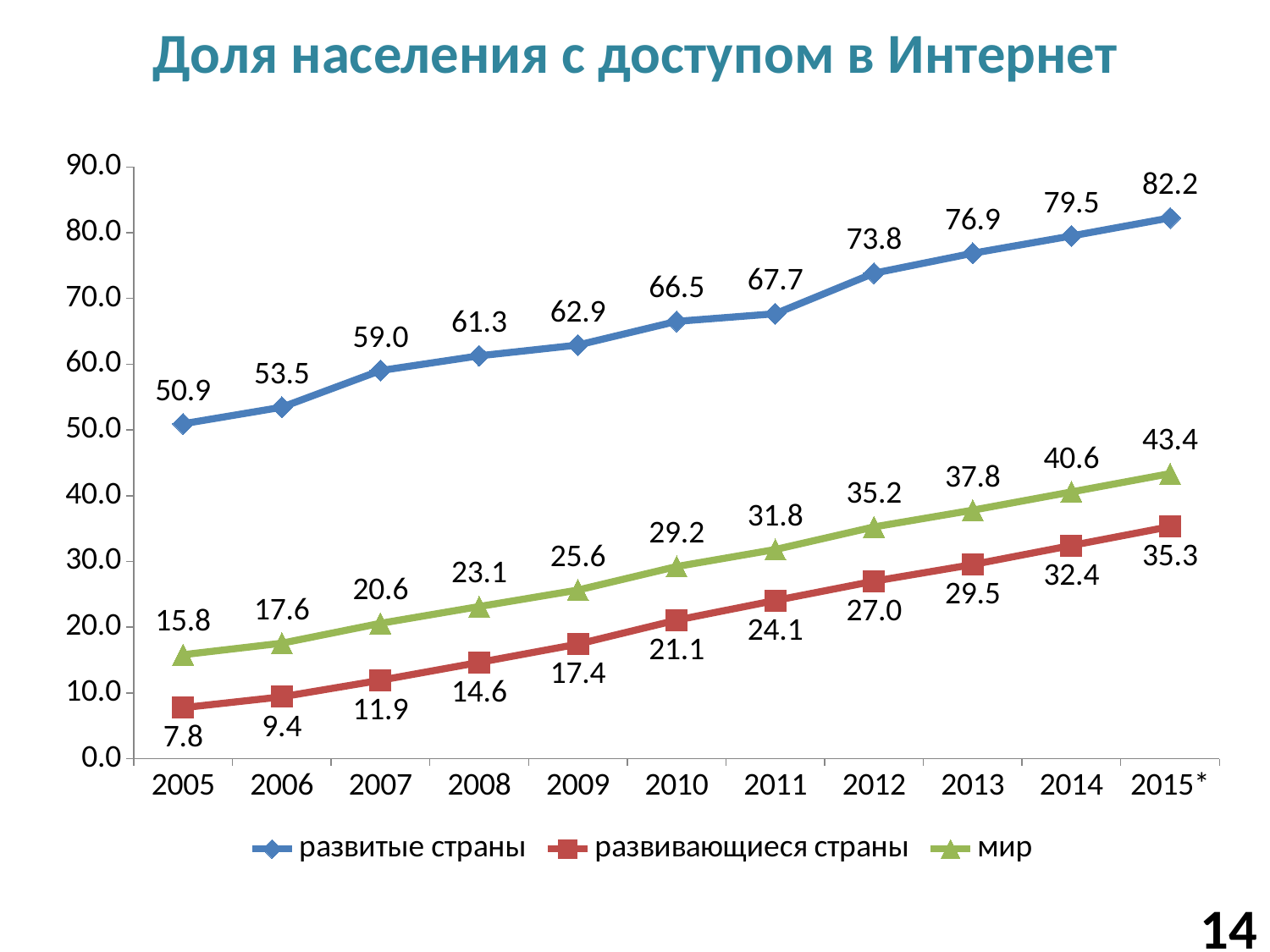
What kind of chart is shown on the slide? line chart What is the value for мир in 2008? 23.1 What is the difference between развитые страны and мир in 2015*? 38.8 Do the values for мир rise or fall from 2005 to 2015*? rise Which is larger in 2012: the value for развивающиеся страны or the value for мир? мир What is the value for развитые страны in 2010? 66.5 What is the value for развивающиеся страны in 2013? 29.5 How many series does the legend list? 3 How many years are shown on the x axis? 11 In which year is the value for развитые страны highest? 2015* In which year is the value for развивающиеся страны lowest? 2005 What is the title of the chart? Доля населения с доступом в Интернет